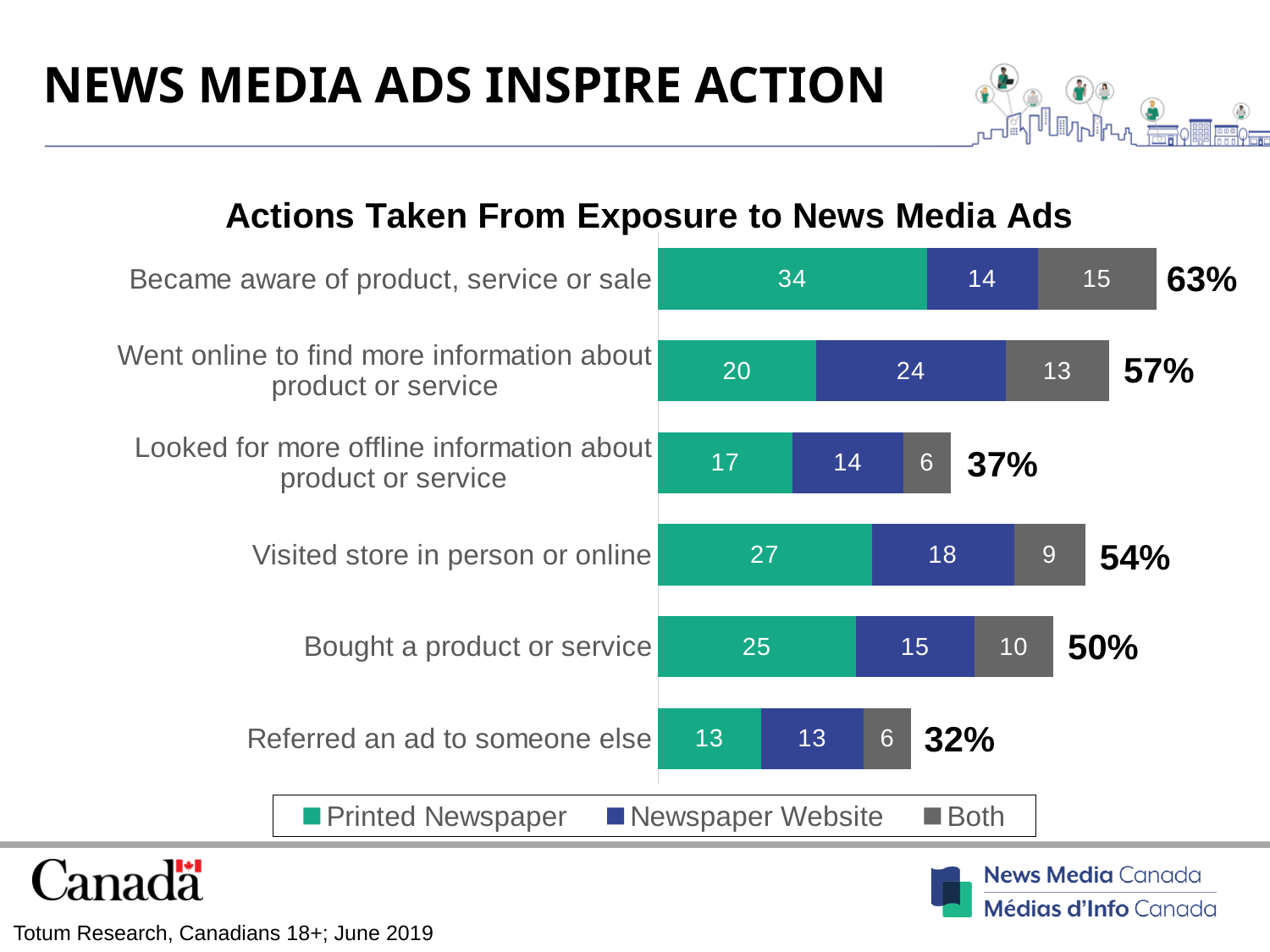
What is the Printed Newspaper value for "Became aware of product, service or sale"? 34 What is the title of the chart? Actions Taken From Exposure to News Media Ads What kind of chart is shown on the slide? Stacked bar chart How many series does the legend list? 3 What is the Both value for "Visited store in person or online"? 9 Which action has the lowest total? Referred an ad to someone else What is the difference between the Printed Newspaper values for "Became aware of product, service or sale" and "Referred an ad to someone else"? 21 Which action has the highest total? Became aware of product, service or sale What is the total shown for "Bought a product or service"? 50% What is the Newspaper Website value for "Went online to find more information about product or service"? 24 Which is larger for "Went online to find more information about product or service": the Printed Newspaper value or the Newspaper Website value? Newspaper Website How many actions (categories) are shown in the chart? 6